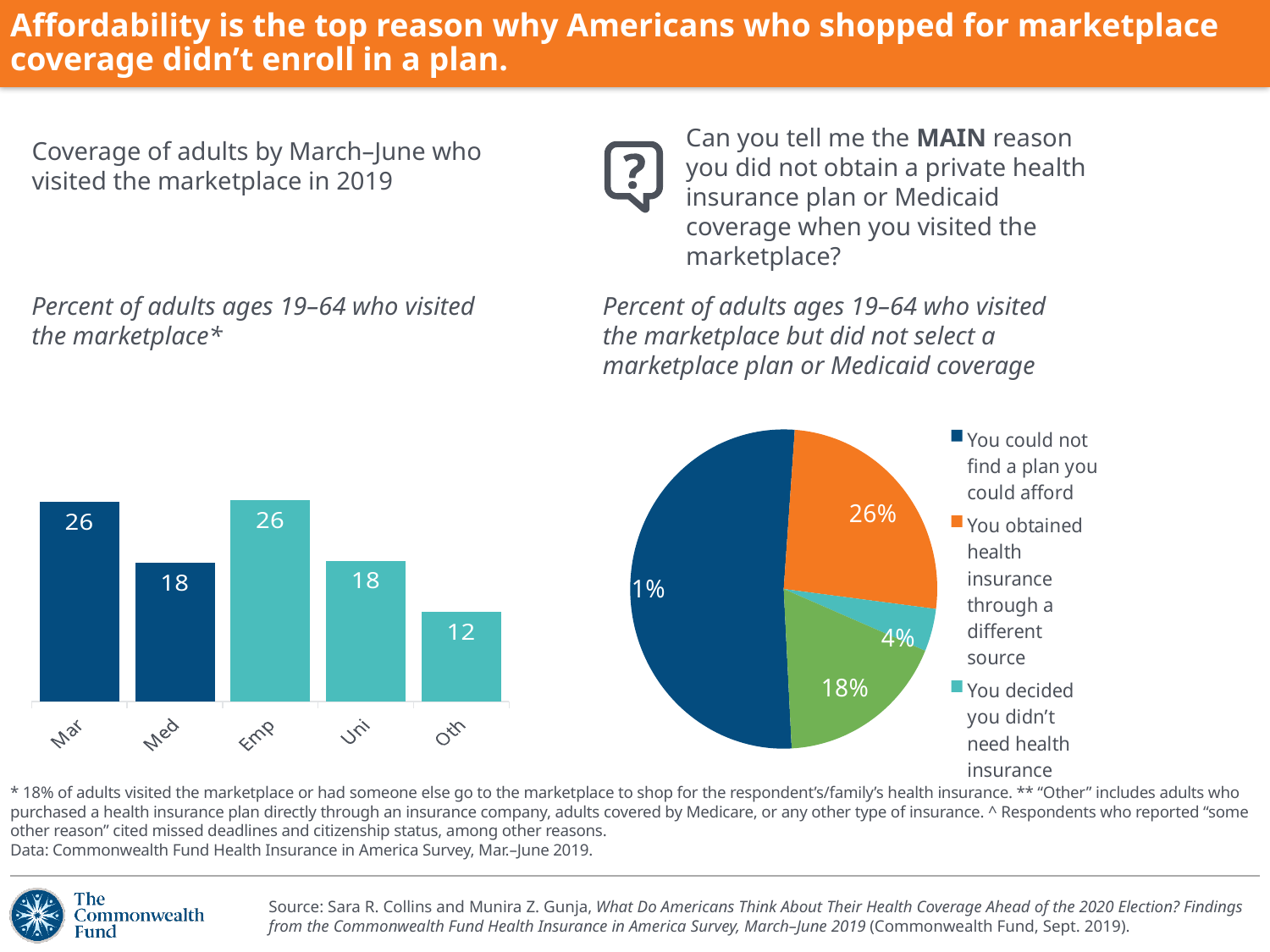
In the bar chart on the left, which is larger, the value for Emp or the value for Uni? Emp In the bar chart on the left, which category has the lowest value? Oth How many categories are shown in the bar chart on the left? 5 In the bar chart on the left, what is the value for Mar? 26 In the pie chart on the right, what share of respondents said they obtained health insurance through a different source? 26% What kind of chart is the chart on the right of the slide? Pie chart In the bar chart on the left, what is the difference between the values for Mar and Oth? 14 In the bar chart on the left, what is the value for Oth? 12 In the pie chart on the right, which reason has the largest slice? You could not find a plan you could afford In the bar chart on the left, what is the value for Med? 18 In the pie chart on the right, what share of respondents said they decided they didn't need health insurance? 4% What kind of chart is the chart on the left of the slide? Bar chart